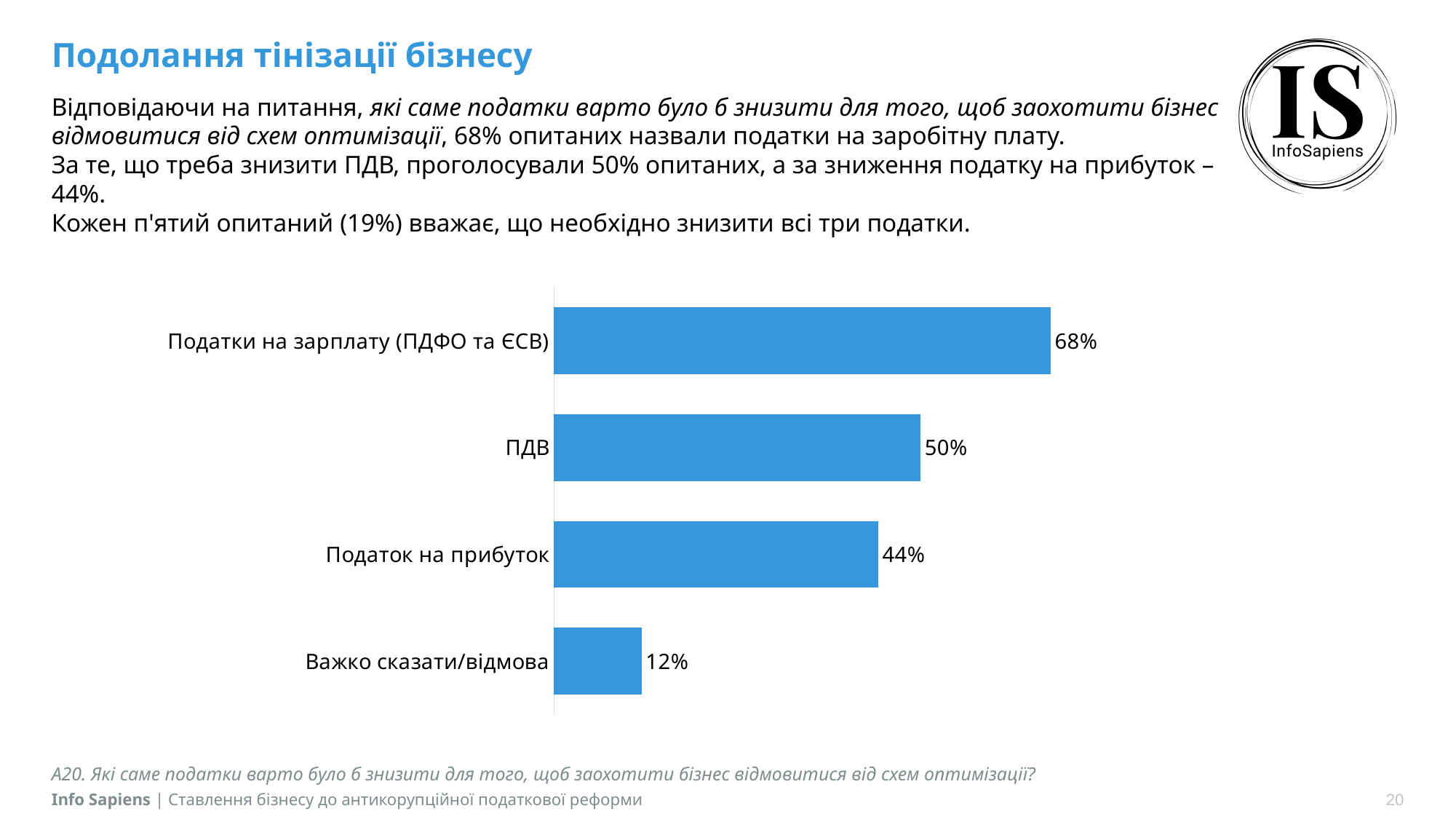
How many categories are shown in the chart? 4 What colour are the bars in the chart? Blue What kind of chart is shown on the slide? Bar chart Which category has the highest value? Податки на зарплату (ПДФО та ЄСВ) What is the value for Податок на прибуток? 44% Which is larger, the value for Податок на прибуток or the value for Важко сказати/відмова? Податок на прибуток Which category has the lowest value? Важко сказати/відмова What is the value for Податки на зарплату (ПДФО та ЄСВ)? 68% What is the value for ПДВ? 50% What is the difference between the values for ПДВ and Податок на прибуток? 6% What is the value for Важко сказати/відмова? 12% What is the difference between the values for Податки на зарплату (ПДФО та ЄСВ) and ПДВ? 18%